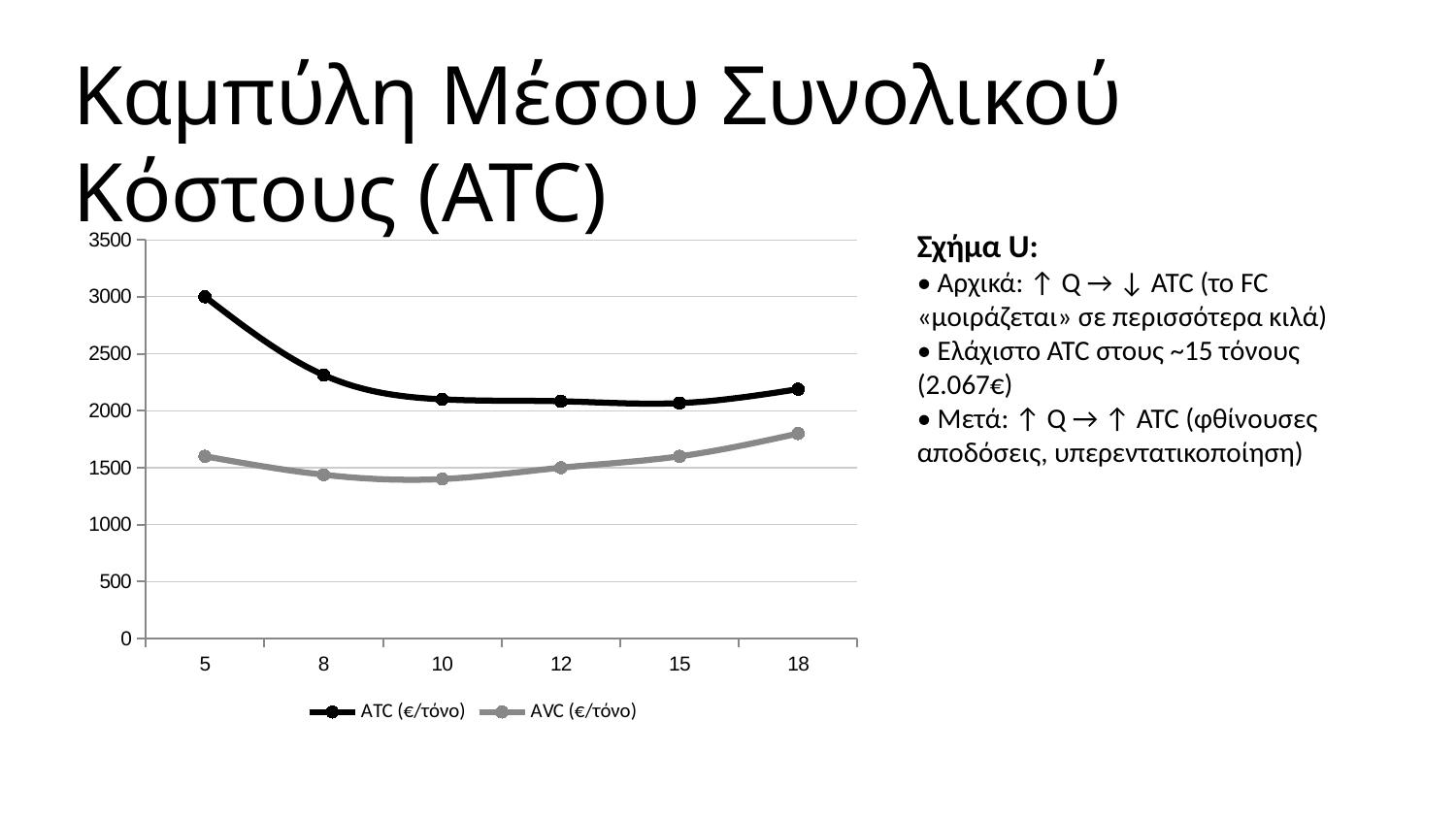
Is the value of AVC (€/τόνο) at x = 10 greater or less than 1500? less What is the value of ATC (€/τόνο) at x = 5? 3000 At x = 5, which series has the larger value, ATC (€/τόνο) or AVC (€/τόνο)? ATC (€/τόνο) How many series does the legend list? 2 At which x value is ATC (€/τόνο) highest? 5 Does the ATC (€/τόνο) series rise or fall from x = 5 to x = 10? fall Does the AVC (€/τόνο) series rise or fall from x = 10 to x = 18? rise Is the value of AVC (€/τόνο) at x = 18 greater or less than 1500? greater How many points are plotted along the x axis for each series? 6 What kind of chart is shown on the slide? line chart Is the value of ATC (€/τόνο) at x = 8 greater or less than 2000? greater At which x value is AVC (€/τόνο) highest? 18